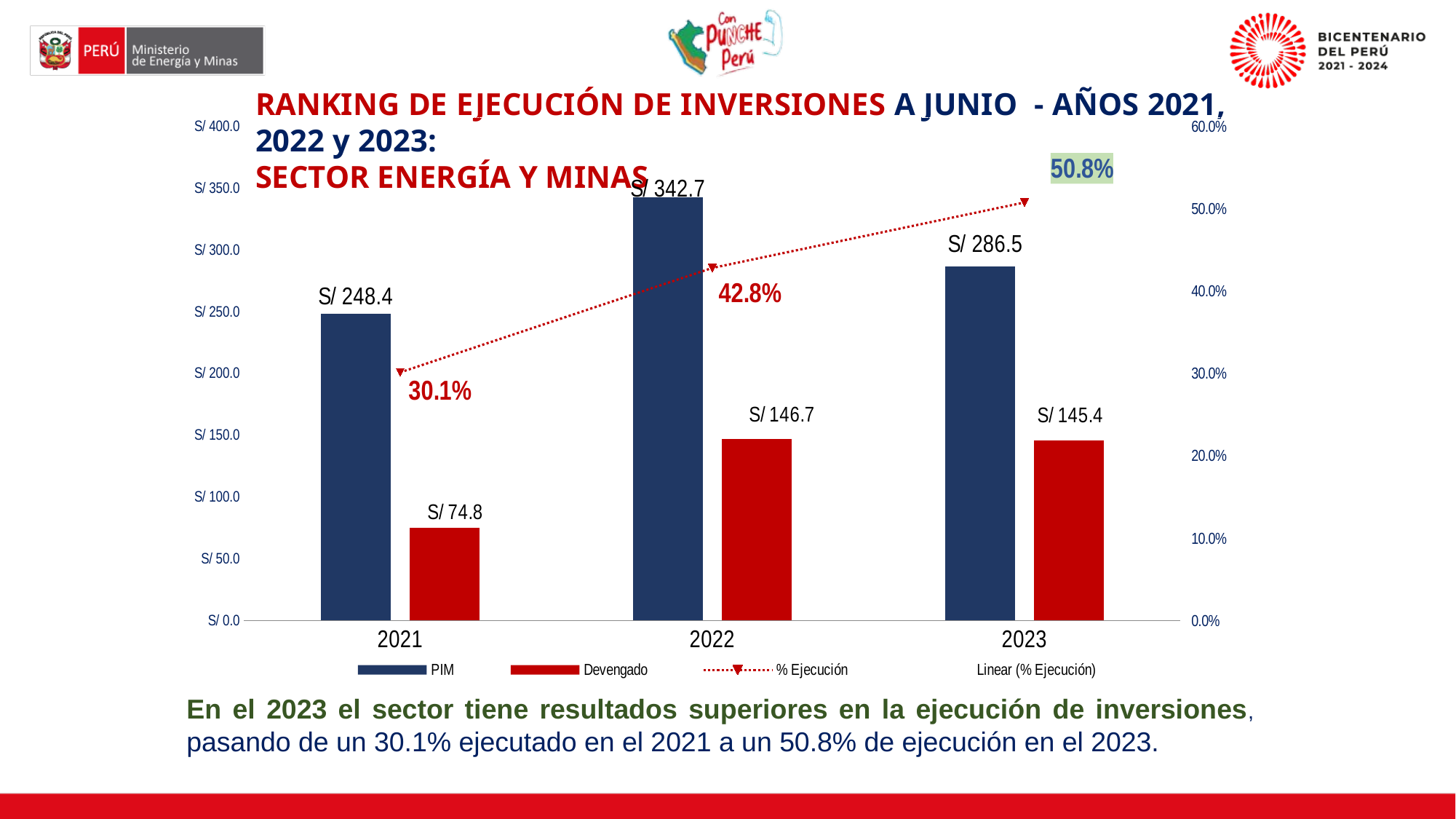
What is the PIM value for 2022? S/ 342.7 Which year has the lowest Devengado value? 2021 What colour are the PIM bars? dark blue Which year has the highest PIM value? 2022 What is the % Ejecución value for 2023? 50.8% Is the PIM value for 2021 greater or less than S/ 200.0? greater What is the Devengado value for 2021? S/ 74.8 How many years are shown on the x axis? 3 What is the difference between the PIM and Devengado values for 2023? S/ 141.1 Which is larger, the Devengado value for 2022 or the Devengado value for 2021? Devengado for 2022 Does the % Ejecución line rise or fall from 2021 to 2023? rise How many entries does the legend list? 4